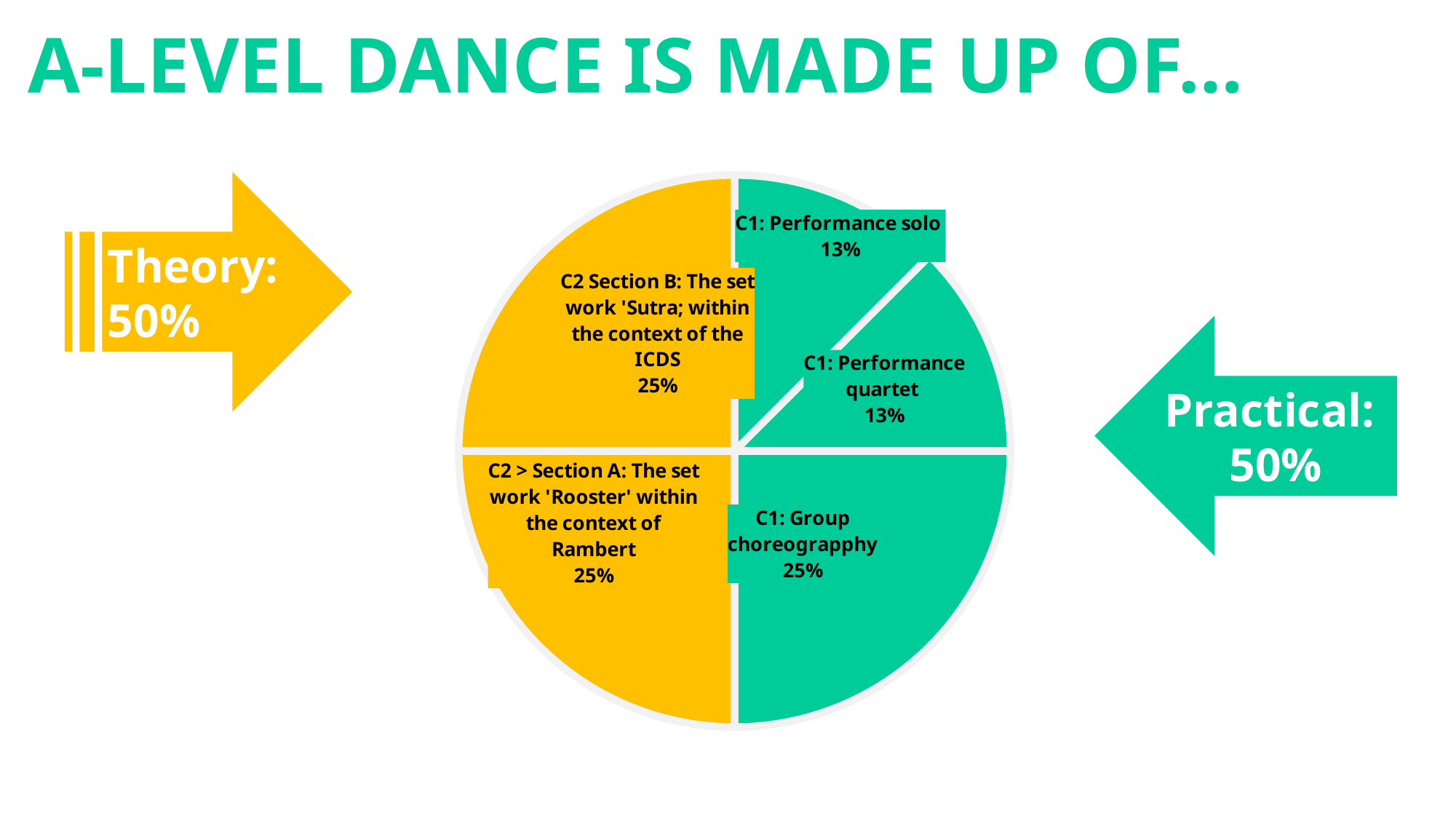
What kind of chart is shown on the slide? Pie chart What percentage is shown for the 'C1: Performance quartet' slice? 13% What colour are the Practical slices of the pie chart? Green What percentage is shown for the 'C1: Performance solo' slice? 13% What percentage is shown for the 'C1: Group choreography' slice? 25% What percentage is shown for the 'C2 Section B: The set work Sutra' slice? 25% What percentage is shown for the 'C2 > Section A: The set work Rooster' slice? 25% What percentage does the slide give for the Theory component? 50% What is the combined share of the two 'C2' slices (Section A and Section B)? 50% What is the difference between the 'C1: Group choreography' slice and the 'C1: Performance quartet' slice? 12% Which slice is larger: 'C1: Group choreography' or 'C1: Performance solo'? C1: Group choreography How many slices does the pie chart have? 5